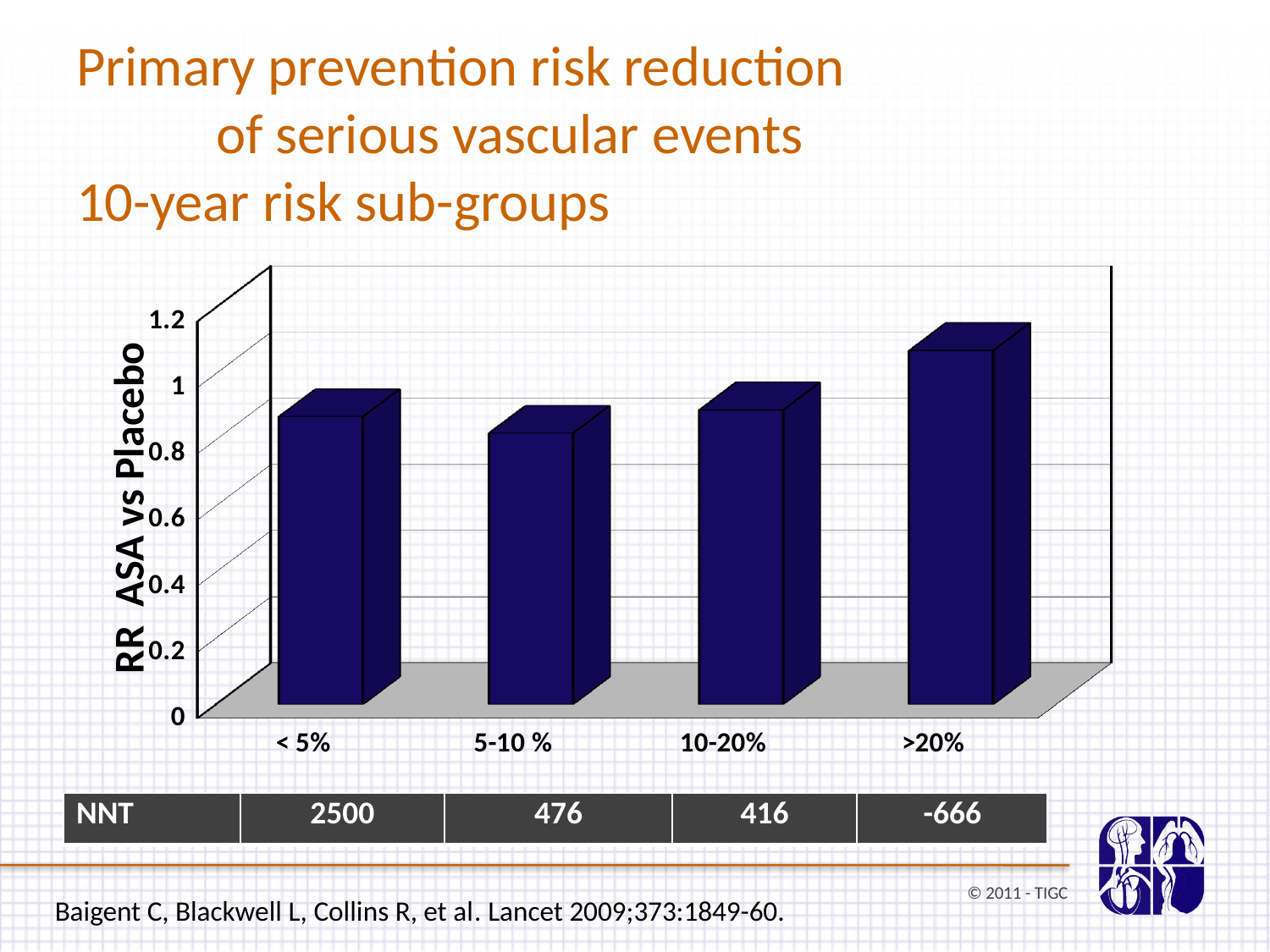
Which has a larger RR ASA vs Placebo, the >20% sub-group or the 5-10 % sub-group? >20% What is the highest value shown on the vertical axis of the chart? 1.2 What is the label on the vertical axis of the chart? RR ASA vs Placebo Which risk sub-group has the highest RR ASA vs Placebo? >20% How many 10-year risk sub-groups are plotted on the chart? 4 Is the RR ASA vs Placebo for the 10-20% sub-group greater or less than 0.6? greater Is the RR ASA vs Placebo for the >20% sub-group greater or less than 1? greater Is the RR ASA vs Placebo for the 5-10 % sub-group greater or less than 1? less What kind of chart is shown on the slide? bar chart What NNT value is listed below the chart for the < 5% sub-group? 2500 Which risk sub-group has the lowest RR ASA vs Placebo? 5-10 %